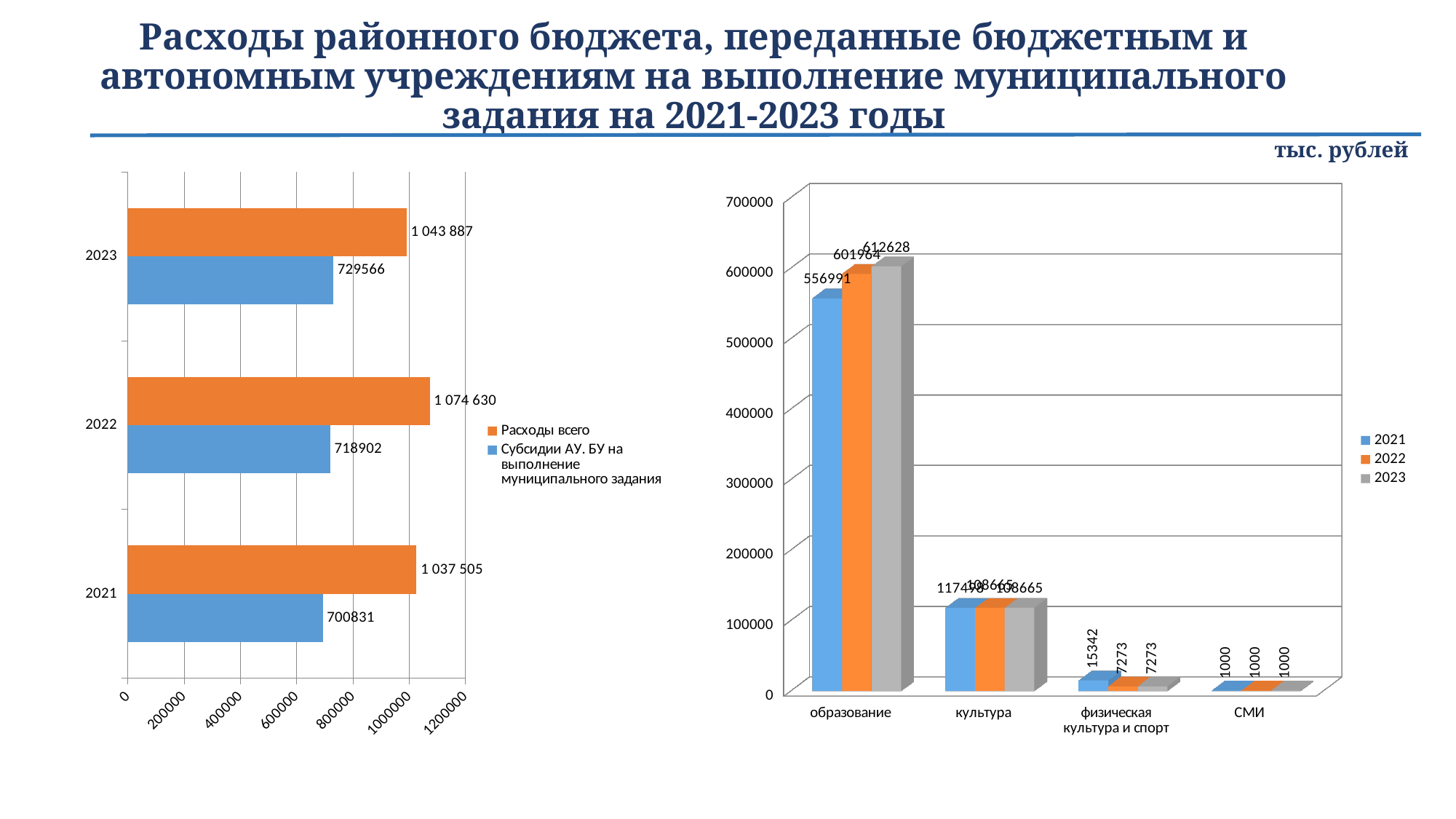
In the left chart, what is the difference between 'Расходы всего' and the subsidies value for 2023? 314 321 In the left chart, what is the value of 'Субсидии АУ, БУ на выполнение муниципального задания' for 2021? 700831 In the right chart, do the values for 'образование' rise or fall from 2021 to 2023? rise In the left chart, is the subsidies value for 2022 greater or less than 800000? less What type of chart is the right chart? bar chart In the left chart, which year has the highest value of 'Расходы всего'? 2022 How many series does the legend of the left chart list? 2 In the right chart, which category has the lowest values? СМИ In the left chart, what is the value of 'Расходы всего' for 2022? 1 074 630 How many categories are shown on the x axis of the right chart? 4 In the right chart, what is the value for 'физическая культура и спорт' in 2021? 15342 In the right chart, what is the value for 'образование' in 2023? 612628